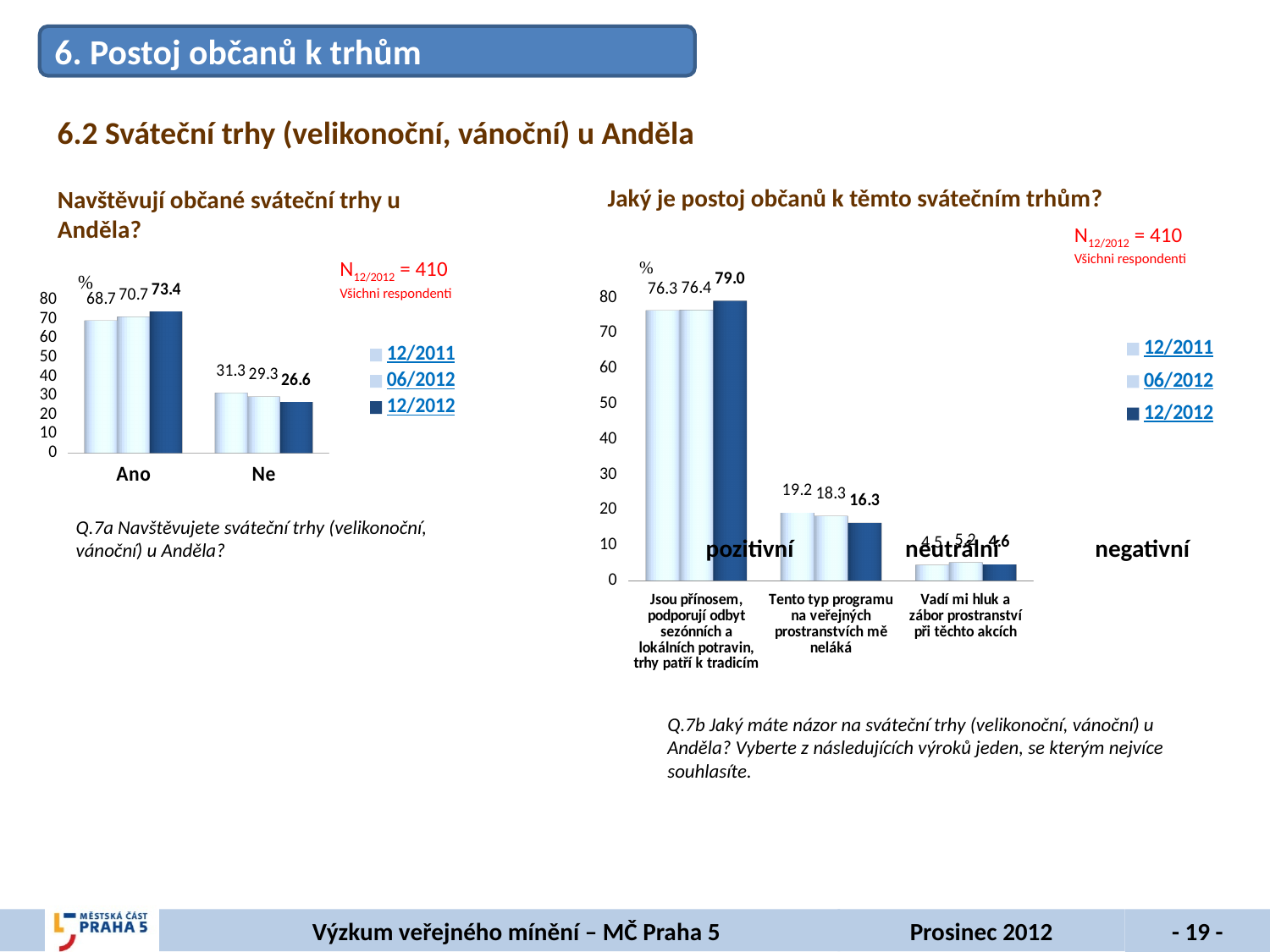
In the left chart (Navštěvují občané sváteční trhy u Anděla?), what is the value for Ne in the 12/2011 series? 31.3 What type of chart is the right chart (Jaký je postoj občanů k těmto svátečním trhům?)? bar chart In the right chart (Jaký je postoj občanů k těmto svátečním trhům?), which category has the lowest values? Vadí mi hluk a zábor prostranství při těchto akcích In the right chart (Jaký je postoj občanů k těmto svátečním trhům?), what is the difference between the 12/2011 and 12/2012 values for 'Tento typ programu na veřejných prostranstvích mě neláká'? 2.9 In the right chart (Jaký je postoj občanů k těmto svátečním trhům?), how many categories are shown on the x axis? 3 In the right chart (Jaký je postoj občanů k těmto svátečním trhům?), what is the 06/2012 value for the category 'Tento typ programu na veřejných prostranstvích mě neláká'? 18.3 In the left chart (Navštěvují občané sváteční trhy u Anděla?), does the value for Ano rise or fall from 12/2011 to 12/2012? rise In the left chart (Navštěvují občané sváteční trhy u Anděla?), what is the value for Ano in the 12/2012 series? 73.4 In the right chart (Jaký je postoj občanů k těmto svátečním trhům?), which category has the highest values? Jsou přínosem, podporují odbyt sezónních a lokálních potravin, trhy patří k tradicím In the left chart (Navštěvují občané sváteční trhy u Anděla?), how many series does the legend list? 3 In the right chart (Jaký je postoj občanů k těmto svátečním trhům?), what is the 12/2012 value for the category 'Jsou přínosem, podporují odbyt sezónních a lokálních potravin, trhy patří k tradicím'? 79.0 In the left chart (Navštěvují občané sváteční trhy u Anděla?), what is the difference between the 12/2012 values for Ano and Ne? 46.8